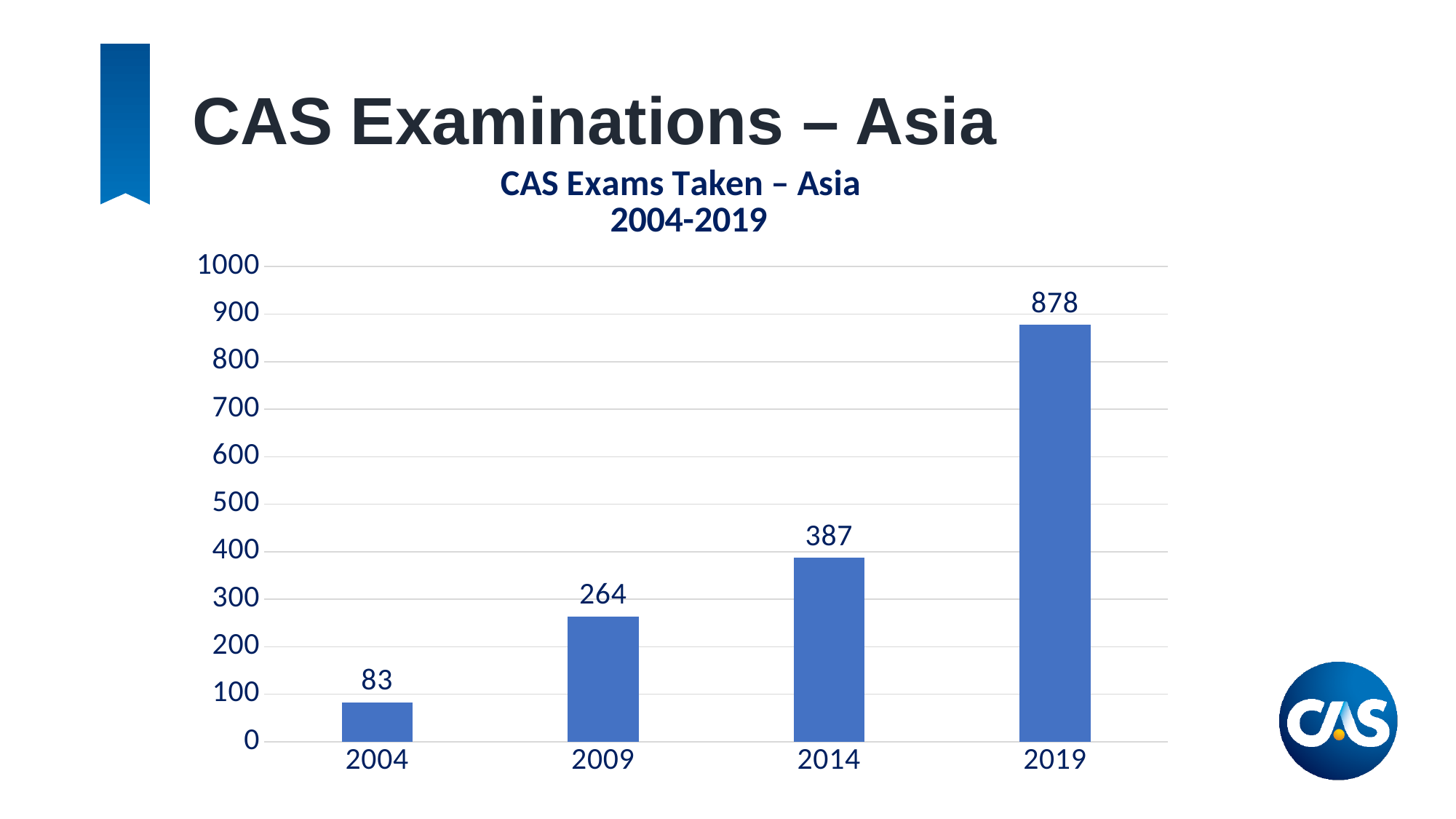
What is the difference between the number of exams taken in 2009 and in 2004? 181 How many CAS exams were taken in Asia in 2019? 878 How many CAS exams were taken in Asia in 2004? 83 What is the difference between the number of exams taken in 2019 and in 2014? 491 How many CAS exams were taken in Asia in 2009? 264 How many years are shown on the x axis of the chart? 4 What kind of chart is shown on the slide? Bar chart Which year has the lowest number of CAS exams taken in Asia? 2004 Which year had more exams taken, 2009 or 2014? 2014 How many CAS exams were taken in Asia in 2014? 387 Which year has the highest number of CAS exams taken in Asia? 2019 Do the values rise or fall from 2004 to 2019? Rise